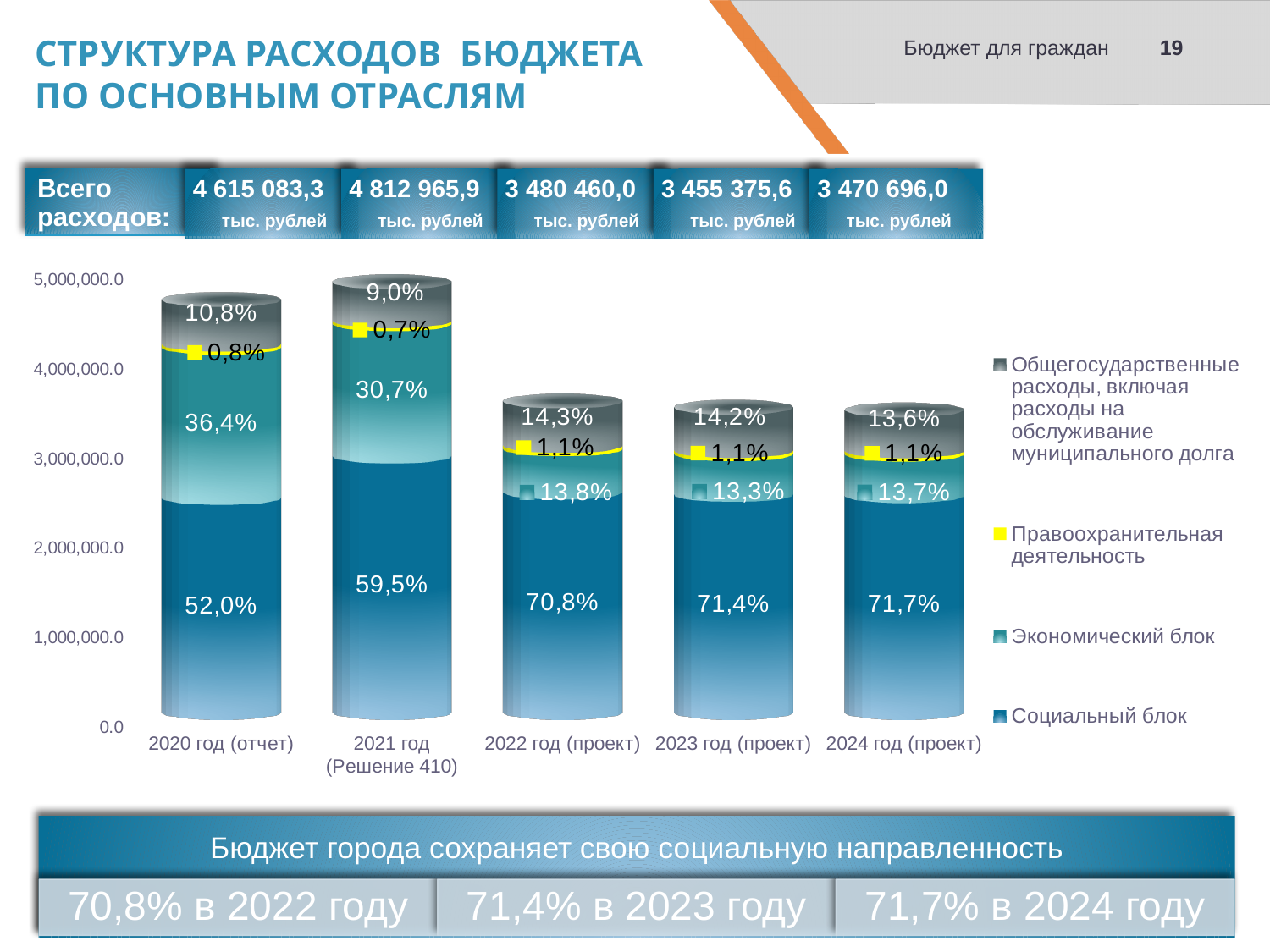
By how many percentage points does the Социальный блок share in 2021 год (Решение 410) exceed that in 2020 год (отчет)? 7,5 percentage points What share does the Экономический блок series have in the 2020 год (отчет) bar? 36,4% Does the Социальный блок share rise or fall from 2020 to 2024 along the x axis? rise What is the total expenditure (Всего расходов) shown for 2023 год (проект)? 3 455 375,6 тыс. рублей In which year does the Социальный блок series have the lowest share? 2020 год (отчет) Which is larger: the Экономический блок share in 2020 год (отчет) or in 2021 год (Решение 410)? 2020 год (отчет) How many series does the legend list? 4 In which year does the Социальный блок series have the highest share? 2024 год (проект) How many years (bars) are shown on the chart? 5 What share does the Социальный блок series have in the 2022 год (проект) bar? 70,8% What share does the Правоохранительная деятельность series have in the 2021 год (Решение 410) bar? 0,7% Is the total height of the 2021 год (Решение 410) bar greater or less than 4,000,000.0? greater